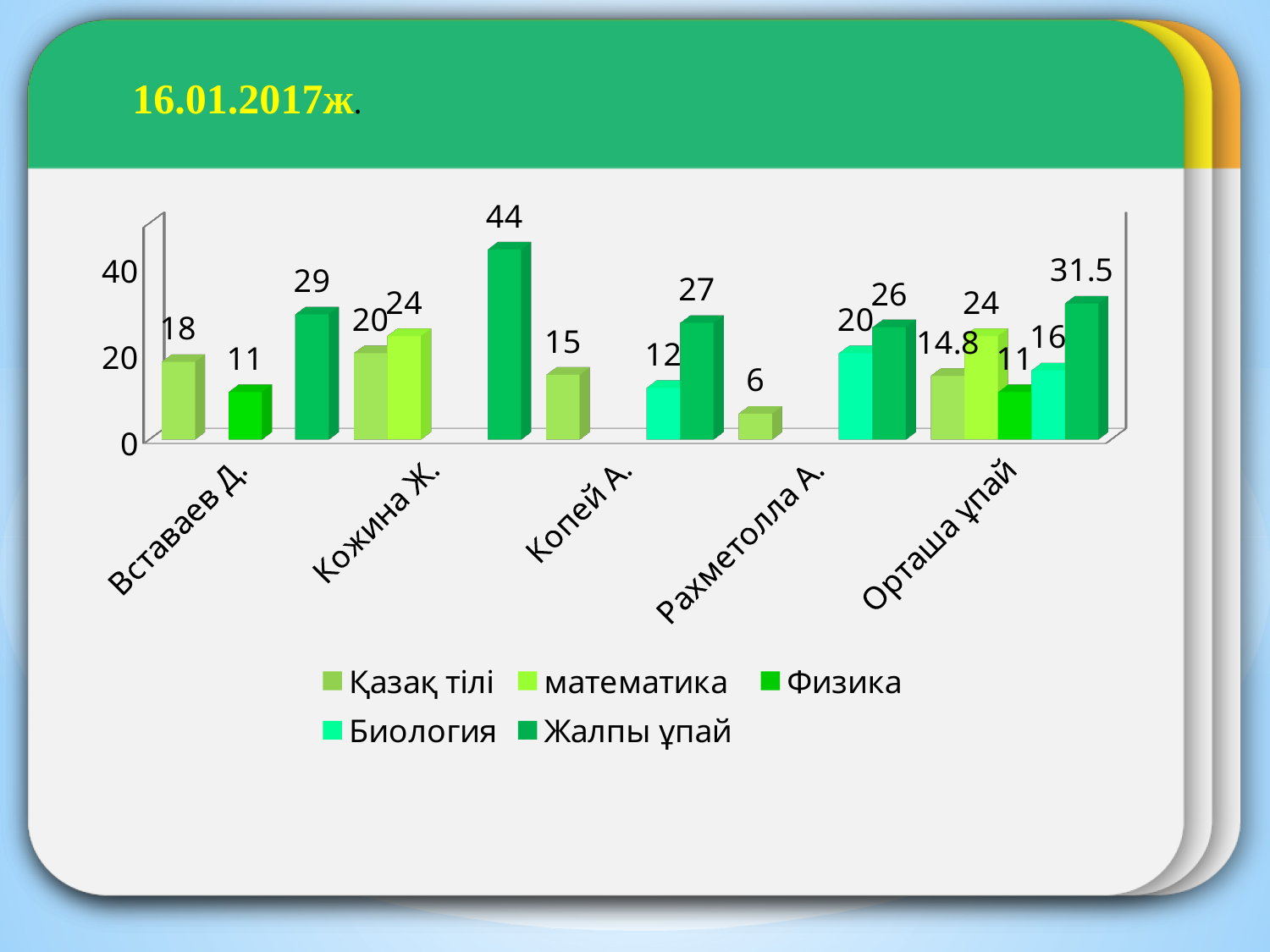
How many categories are shown on the x axis? 5 Which series is shown in the darkest green colour in the legend? Жалпы ұпай What is the Жалпы ұпай value for Кожина Ж.? 44 What is the Физика value for Вставаев Д.? 11 Which category has the lowest Қазақ тілі value? Рахметолла А. What kind of chart is shown on the slide? Bar chart How many series does the legend list? 5 Which has the larger Биология value, Копей А. or Рахметолла А.? Рахметолла А. Which category has the highest Жалпы ұпай value? Кожина Ж. What is the Қазақ тілі value for Орташа ұпай? 14.8 For Орташа ұпай, what is the difference between the математика and Физика values? 13 What is the difference between the Жалпы ұпай values for Кожина Ж. and Вставаев Д.? 15